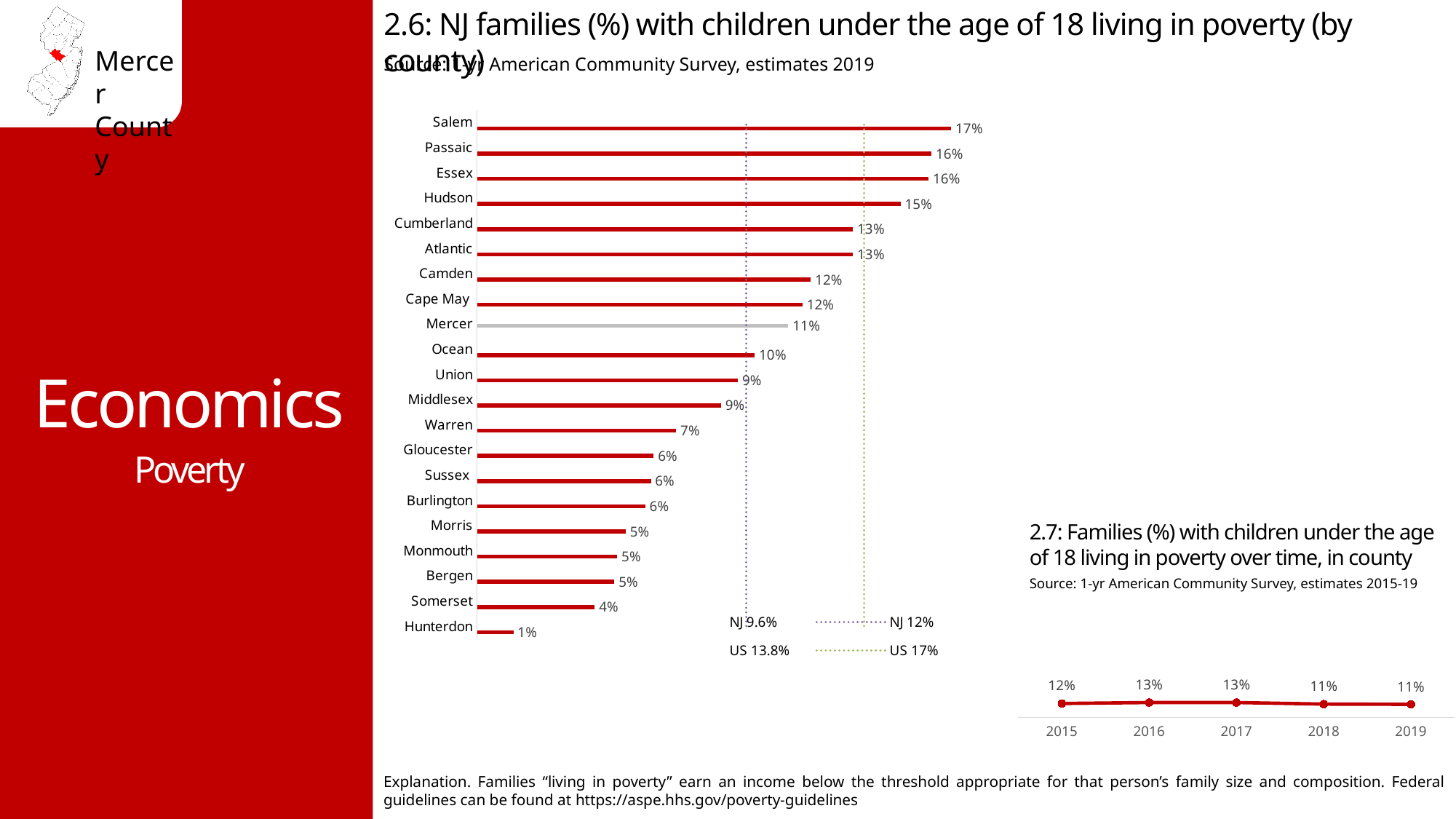
In chart 2.6, which county has the lowest value? Hunterdon In chart 2.6 (NJ families with children under 18 living in poverty by county), what is the value for Mercer? 11% In chart 2.6, which county has the highest value? Salem In chart 2.7 (families in poverty over time, in county), what is the value for 2016? 13% What kind of chart is chart 2.6? Bar chart In chart 2.6, how many counties are plotted? 21 In chart 2.6, what is the difference between the values for Salem and Hunterdon? 16% In chart 2.6, which has a larger value, Camden or Warren? Camden In chart 2.7, what is the difference between the values for 2017 and 2019? 2% In chart 2.6, what is the value for Hudson? 15% In chart 2.7, how many years are plotted? 5